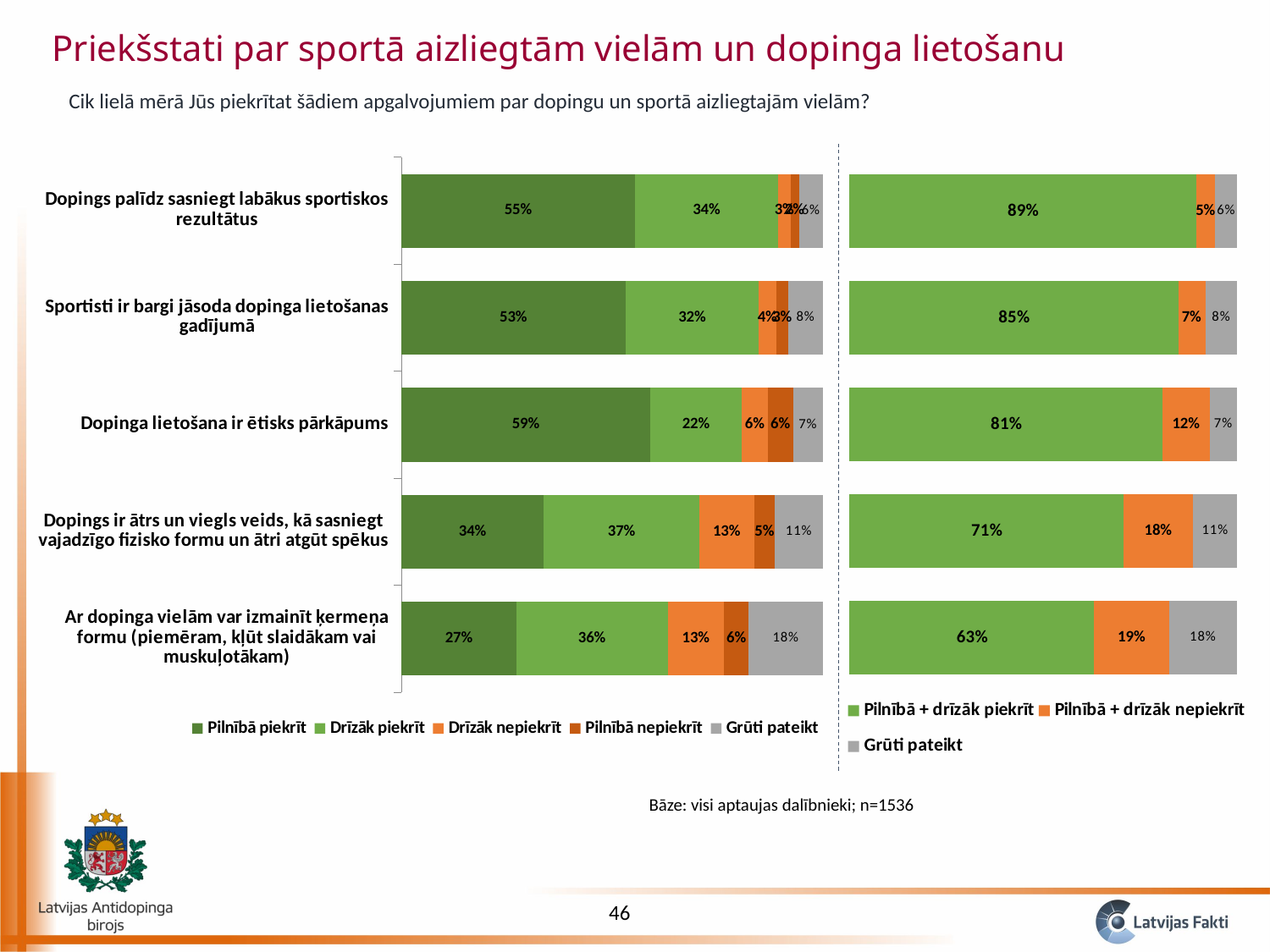
In the right chart, what is the value of "Pilnībā + drīzāk piekrīt" for "Dopings palīdz sasniegt labākus sportiskos rezultātus"? 89% What type of chart is the right chart? Stacked bar chart In the right chart, what is the value of "Pilnībā + drīzāk nepiekrīt" for "Ar dopinga vielām var izmainīt ķermeņa formu (piemēram, kļūt slaidākam vai muskuļotākam)"? 19% In the left chart, what is the value of "Drīzāk piekrīt" for "Dopings ir ātrs un viegls veids, kā sasniegt vajadzīgo fizisko formu un ātri atgūt spēkus"? 37% In the left chart, which is larger for "Ar dopinga vielām var izmainīt ķermeņa formu (piemēram, kļūt slaidākam vai muskuļotākam)": "Pilnībā piekrīt" or "Drīzāk piekrīt"? Drīzāk piekrīt How many series does the legend of the left chart list? 5 In the left chart, which statement has the highest "Pilnībā piekrīt" value? Dopinga lietošana ir ētisks pārkāpums In the right chart, what is the difference between the "Pilnībā + drīzāk piekrīt" values for "Sportisti ir bargi jāsoda dopinga lietošanas gadījumā" and "Dopings ir ātrs un viegls veids, kā sasniegt vajadzīgo fizisko formu un ātri atgūt spēkus"? 14% How many statements (categories) are shown in the left chart? 5 In the right chart, which statement has the highest "Grūti pateikt" value? Ar dopinga vielām var izmainīt ķermeņa formu (piemēram, kļūt slaidākam vai muskuļotākam) In the right chart, which statement has the lowest "Pilnībā + drīzāk piekrīt" value? Ar dopinga vielām var izmainīt ķermeņa formu (piemēram, kļūt slaidākam vai muskuļotākam) In the left chart, what is the value of "Pilnībā piekrīt" for "Dopinga lietošana ir ētisks pārkāpums"? 59%